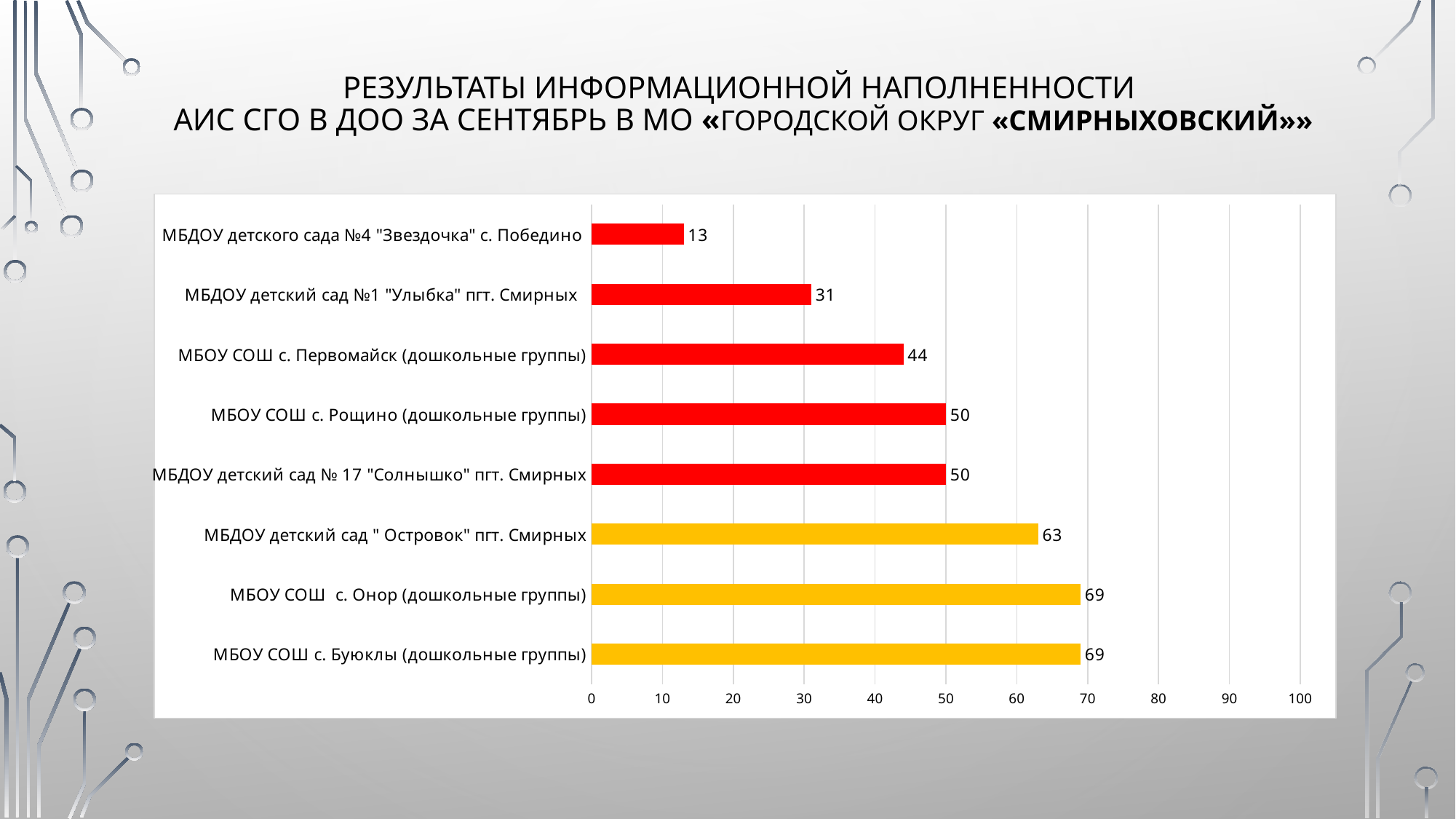
What is the value for МБОУ СОШ с. Онор (дошкольные группы)? 69 What is the difference between the values for МБОУ СОШ с. Буюклы (дошкольные группы) and МБДОУ детского сада №4 "Звездочка" с. Победино? 56 How many categories are shown in the chart? 8 What colour are the bars for the three categories with the highest values? yellow Which is larger: the value for МБОУ СОШ с. Первомайск (дошкольные группы) or the value for МБДОУ детский сад №1 "Улыбка" пгт. Смирных? МБОУ СОШ с. Первомайск (дошкольные группы) What is the value for МБДОУ детский сад "Островок" пгт. Смирных? 63 What is the difference between the values for МБДОУ детский сад "Островок" пгт. Смирных and МБОУ СОШ с. Рощино (дошкольные группы)? 13 What is the value for МБДОУ детский сад №1 "Улыбка" пгт. Смирных? 31 What is the value for МБОУ СОШ с. Первомайск (дошкольные группы)? 44 Is the value for МБДОУ детский сад № 17 "Солнышко" пгт. Смирных greater or less than 40? greater Which category has the lowest value? МБДОУ детского сада №4 "Звездочка" с. Победино What kind of chart is shown on the slide? bar chart